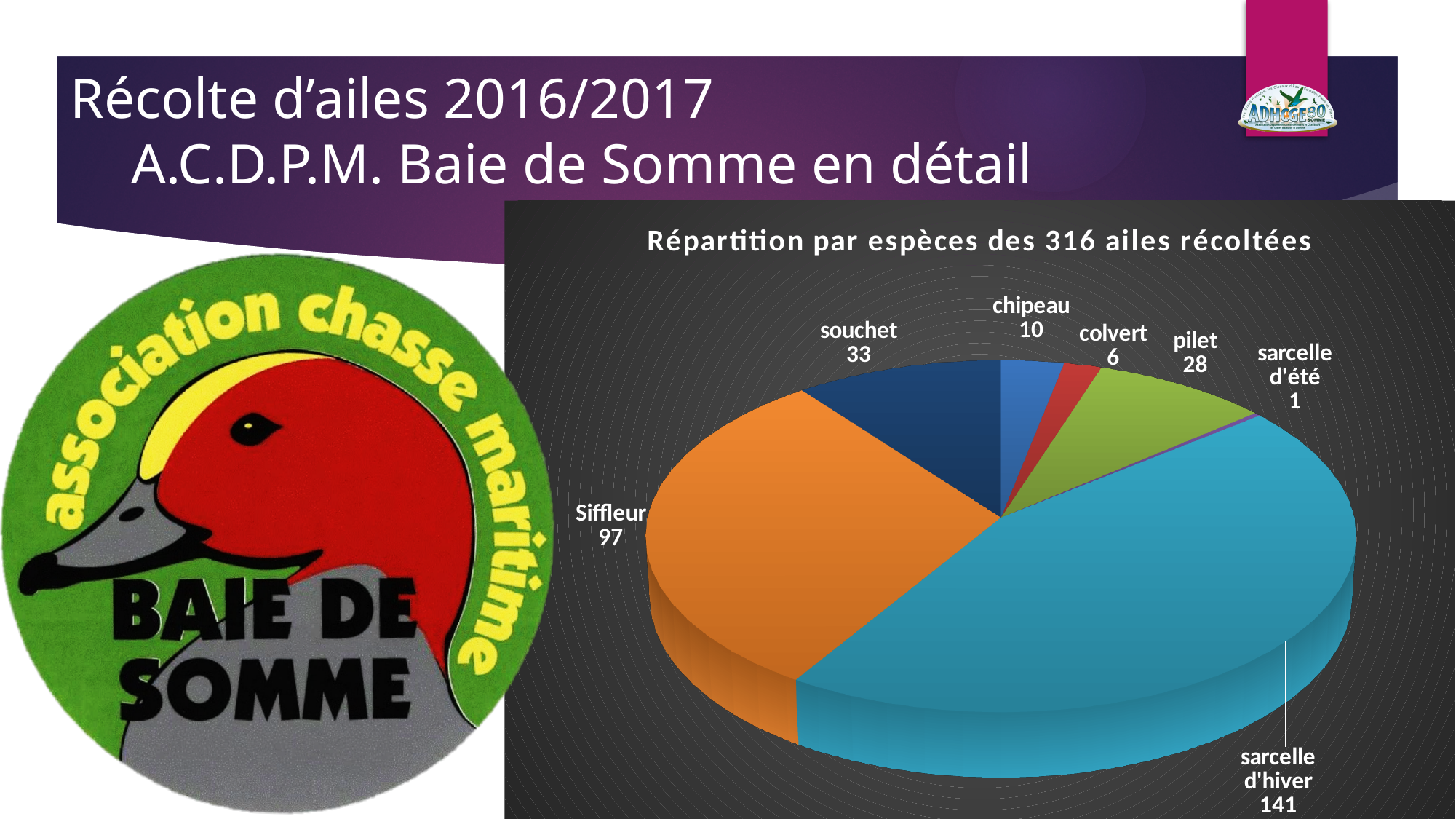
What is the difference between the values for sarcelle d'hiver and Siffleur? 44 What is the combined value of chipeau and colvert? 16 What is the value for souchet? 33 Which is larger, the value for souchet or the value for pilet? souchet What is the title of the chart? Répartition par espèces des 316 ailes récoltées What kind of chart is shown on the slide? pie chart Which species has the smallest slice of the pie? sarcelle d'été What is the value for pilet? 28 Which species has the largest slice of the pie? sarcelle d'hiver What is the value for Siffleur? 97 How many species (slices) are shown in the pie chart? 7 How many wings were collected for sarcelle d'hiver? 141